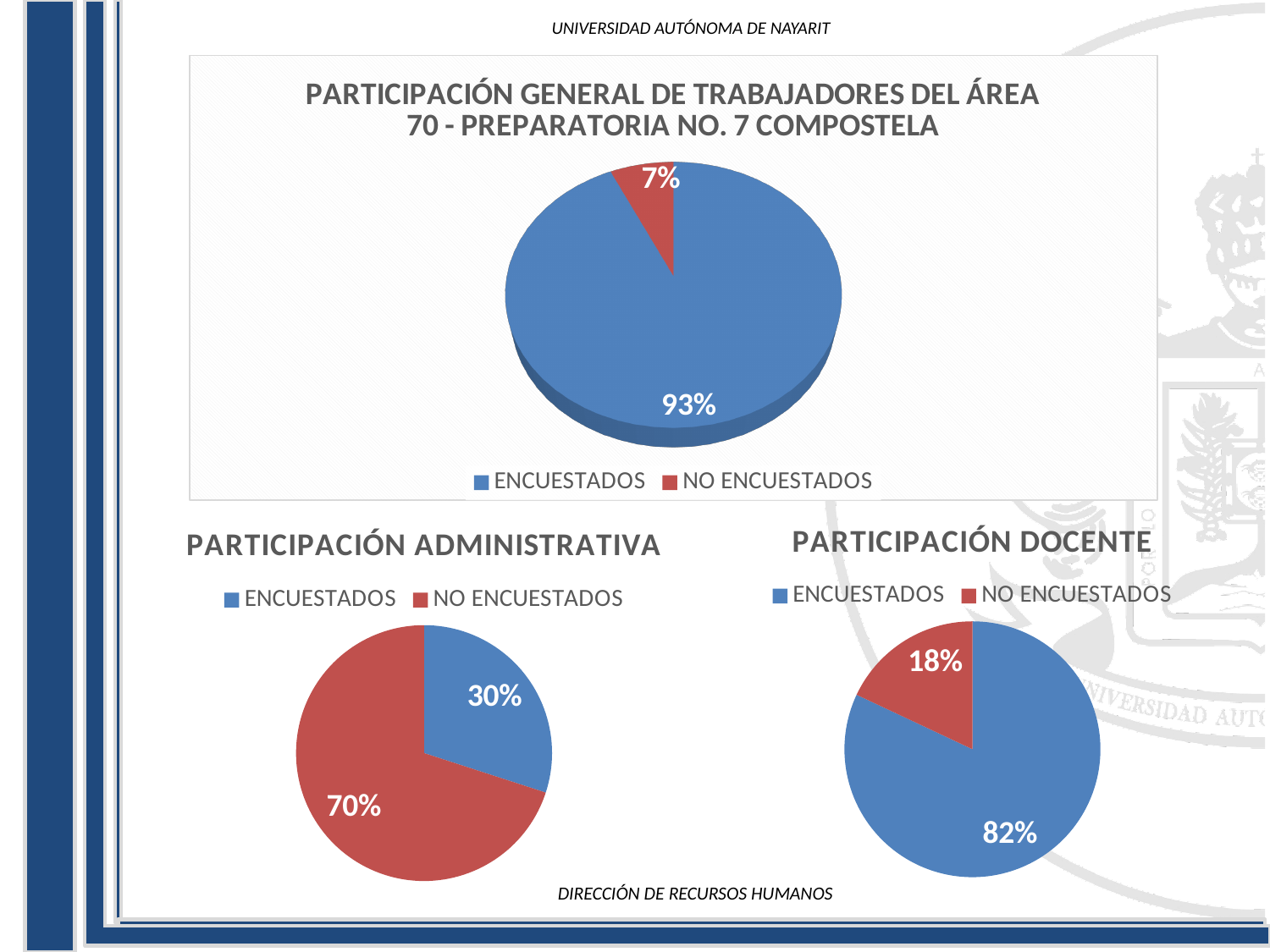
In the 'PARTICIPACIÓN ADMINISTRATIVA' chart, which category has the largest slice? NO ENCUESTADOS What kind of chart is the 'PARTICIPACIÓN DOCENTE' chart? Pie chart In the chart titled 'PARTICIPACIÓN GENERAL DE TRABAJADORES DEL ÁREA 70 - PREPARATORIA NO. 7 COMPOSTELA', what share is ENCUESTADOS? 93% In the 'PARTICIPACIÓN ADMINISTRATIVA' chart, what share is ENCUESTADOS? 30% In the 'PARTICIPACIÓN DOCENTE' chart, what share is NO ENCUESTADOS? 18% In the 'PARTICIPACIÓN ADMINISTRATIVA' chart, which is larger, ENCUESTADOS or NO ENCUESTADOS? NO ENCUESTADOS In the 'PARTICIPACIÓN DOCENTE' chart, what is the difference between the ENCUESTADOS and NO ENCUESTADOS shares? 64% In the 'PARTICIPACIÓN DOCENTE' chart, which category has the smallest slice? NO ENCUESTADOS How many entries does the legend of the 'PARTICIPACIÓN ADMINISTRATIVA' chart list? 2